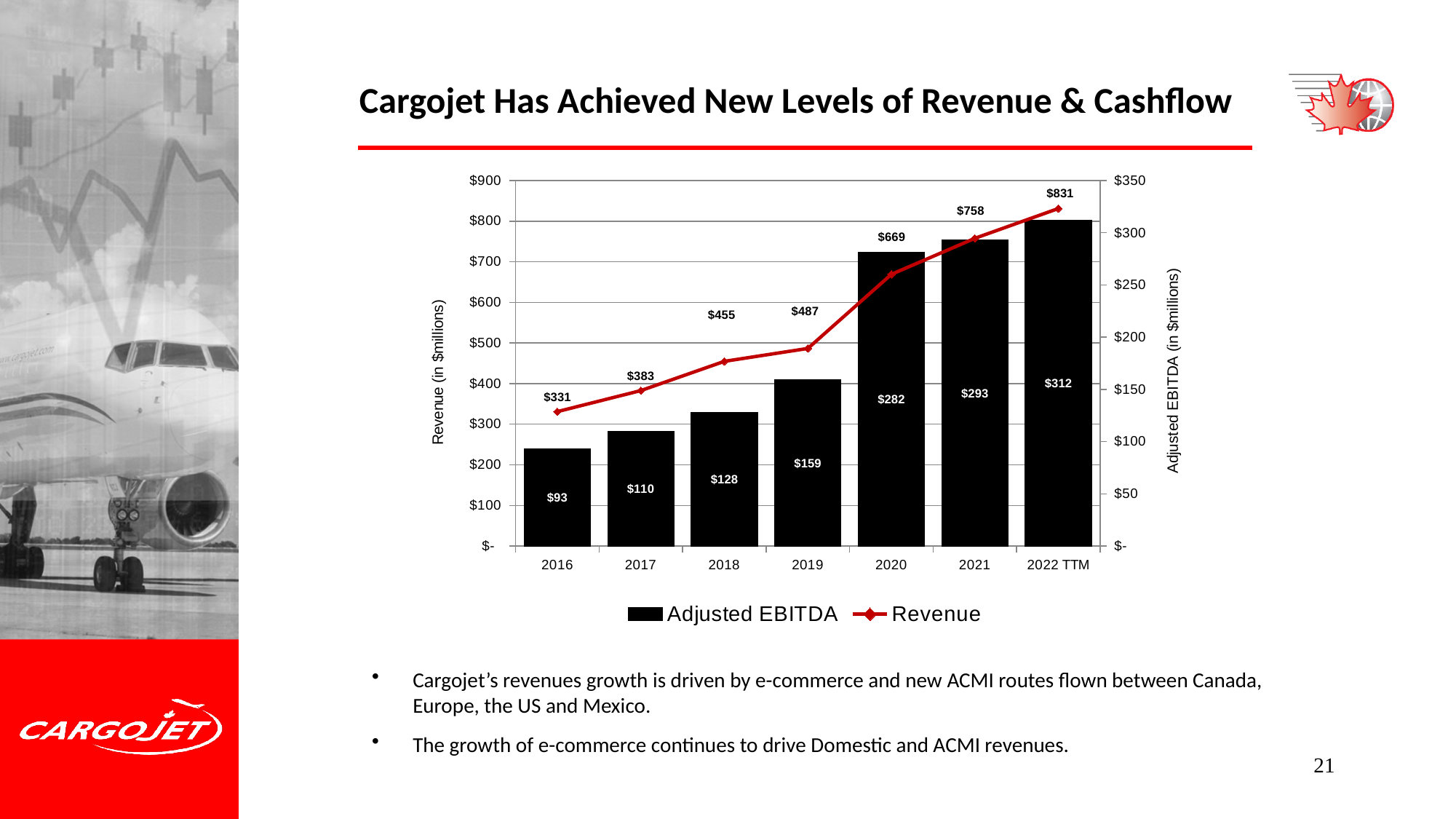
Which is larger, Revenue in 2017 or Revenue in 2018? Revenue in 2018 Which year has the lowest Adjusted EBITDA? 2016 What was the Adjusted EBITDA in 2019? $159 How many time periods are shown on the x axis? 7 Which period has the highest Revenue? 2022 TTM How many series does the legend list? 2 Which series is plotted as a line rather than bars? Revenue Does Revenue rise or fall from 2016 to 2022 TTM? Rises What is the difference in Adjusted EBITDA between 2021 and 2020? $11 By how much did Revenue increase from 2019 to 2020? $182 What was Cargojet's Revenue in 2020? $669 What was the Adjusted EBITDA for 2022 TTM? $312